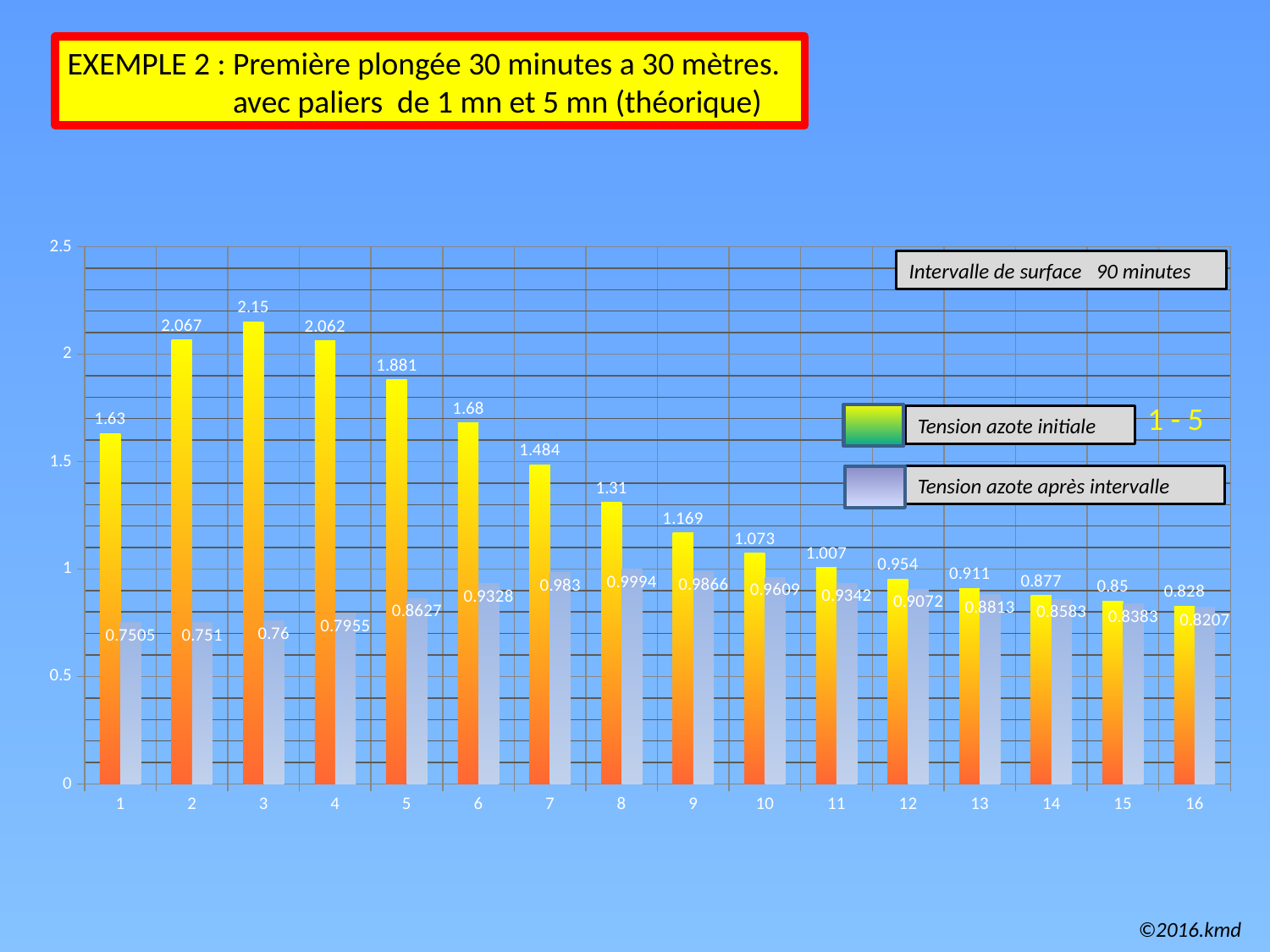
What kind of chart is shown on the slide? bar chart How many series does the legend list? 2 What surface interval is stated in the box on the chart? 90 minutes Is the 'Tension azote initiale' value for category 5 greater or less than 1.5? greater What is the 'Tension azote initiale' value for category 16? 0.828 For category 9, which is larger: 'Tension azote initiale' or 'Tension azote après intervalle'? Tension azote initiale What is the difference between the 'Tension azote initiale' value for category 1 and its 'Tension azote après intervalle' value? 0.8795 How many categories are shown on the x axis? 16 Which category has the lowest 'Tension azote après intervalle' value? 1 What is the 'Tension azote initiale' value for category 3? 2.15 What is the 'Tension azote après intervalle' value for category 8? 0.9994 Which category has the highest 'Tension azote initiale' value? 3